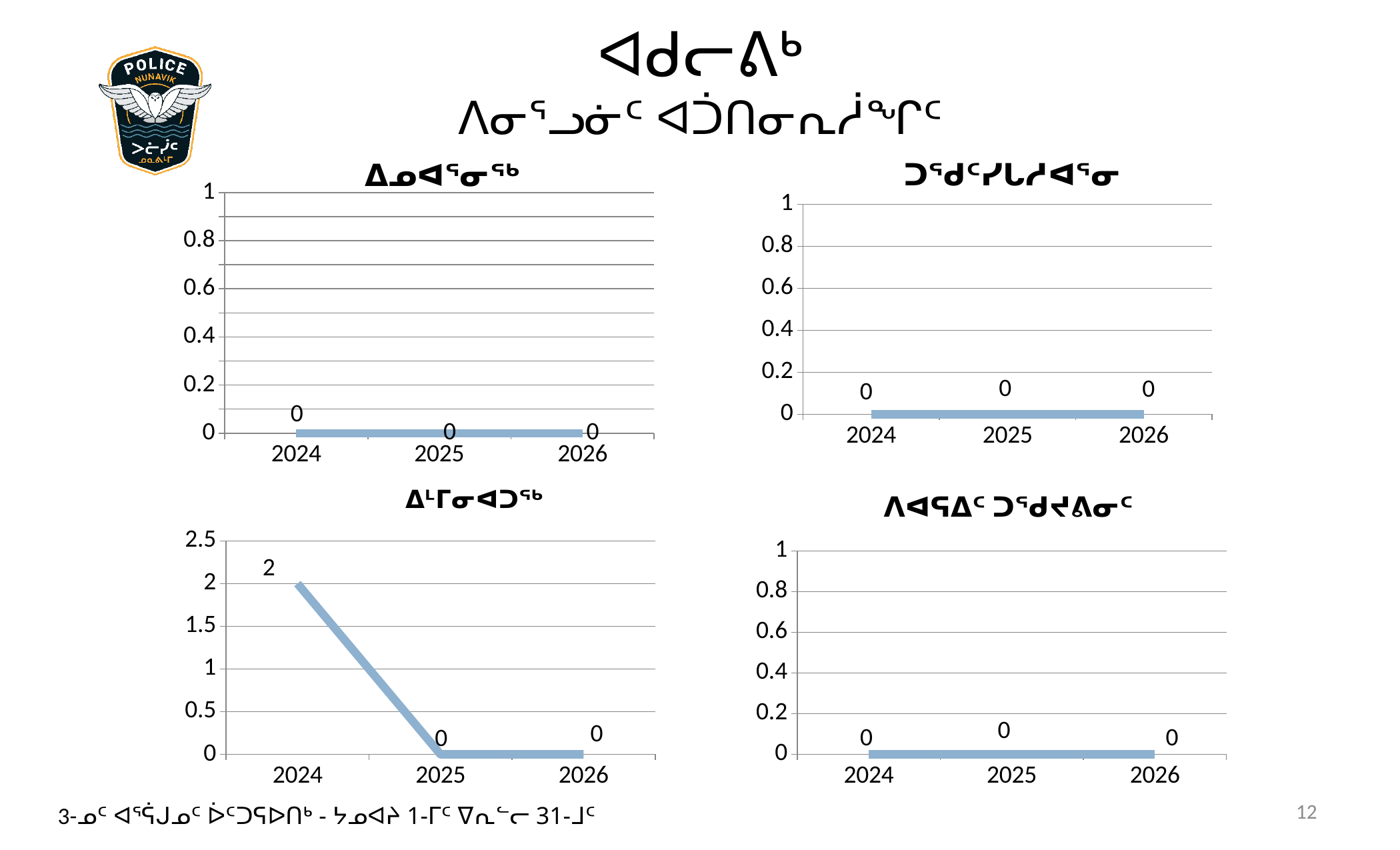
In the bottom-left chart, what is the difference between the values for 2024 and 2026? 2 In the bottom-left chart, what is the value for 2025? 0 What kind of chart is the bottom-left chart? line chart How many charts are shown on the slide? 4 In the bottom-left chart, what is the value for 2024? 2 In the top-right chart, what is the value for 2025? 0 In the bottom-left chart, which year has the highest value? 2024 How many years are plotted on the x axis of the bottom-right chart? 3 In the bottom-left chart, which is larger, the value for 2024 or the value for 2025? 2024 In the top-left chart, what is the value for 2026? 0 In the bottom-left chart, is the value for 2024 greater or less than 1.5? greater In the bottom-left chart, do the values rise or fall from 2024 to 2025? fall